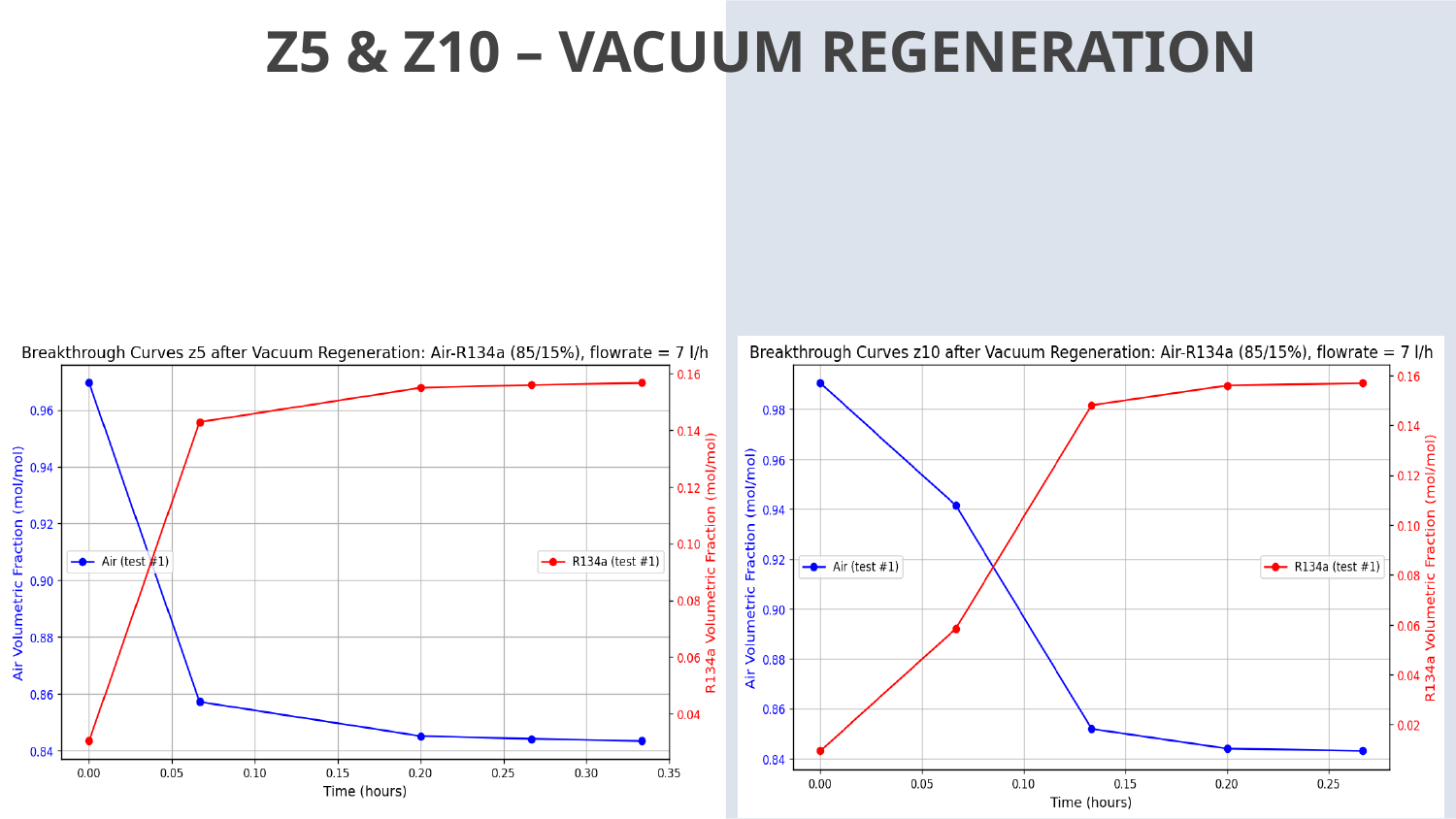
In the right chart (z10), at which time is the R134a Volumetric Fraction lowest? 0.00 hours In the right chart (z10), how many data points are plotted for the R134a (test #1) series? 5 In the right chart (z10), does the R134a Volumetric Fraction rise or fall as time increases? rise In the left chart (z5), how many data points are plotted for the Air (test #1) series? 5 In the right chart (z10), is the R134a Volumetric Fraction at about 0.07 hours greater or less than 0.04? greater In the left chart (z5), is the Air Volumetric Fraction at time 0.00 hours greater or less than 0.96? greater In the left chart (z5), does the Air Volumetric Fraction rise or fall as time increases? fall In the right chart (z10), what is the label of the x axis? Time (hours) What type of chart is the left chart (Breakthrough Curves z5 after Vacuum Regeneration)? line chart How many series does the legend list in the right chart (Breakthrough Curves z10 after Vacuum Regeneration)? 2 In the left chart (z5), at which time is the Air Volumetric Fraction highest? 0.00 hours In the left chart (z5), is the Air Volumetric Fraction at time 0.20 hours greater or less than 0.86? less